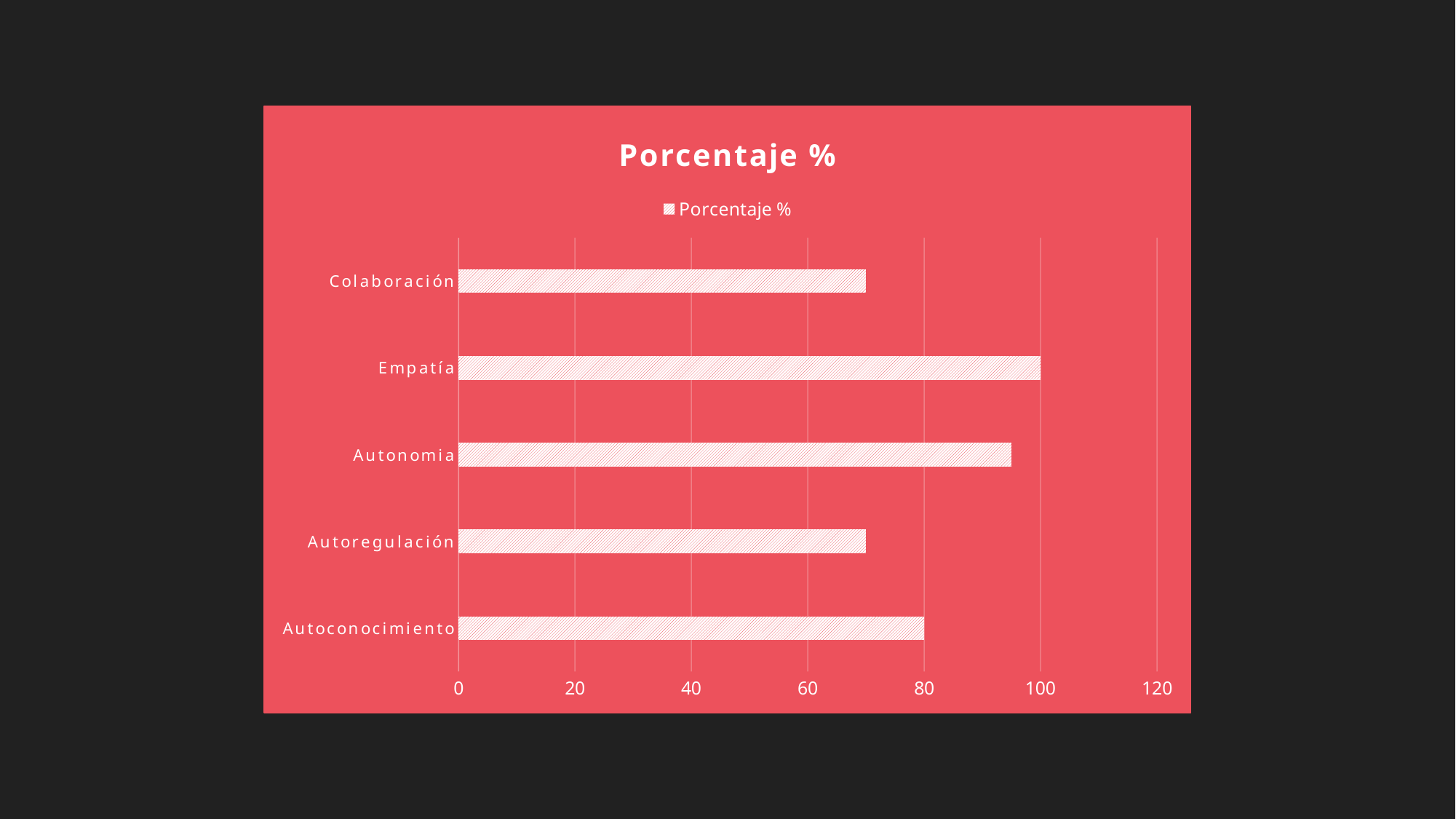
Which is larger, the value for Autonomia or the value for Autoconocimiento? Autonomia How many categories are plotted in the chart? 5 What is the title of the chart? Porcentaje % What is the value for Autoconocimiento? 80 What is the difference between the values for Empatía and Autoconocimiento? 20 What type of chart is shown on the slide? bar chart Is the value for Colaboración greater or less than 60? greater Which category has the highest value? Empatía Is the value for Autonomia greater or less than 100? less What is the value for Empatía? 100 How many series does the legend list? 1 Is the value for Autoregulación greater or less than 80? less